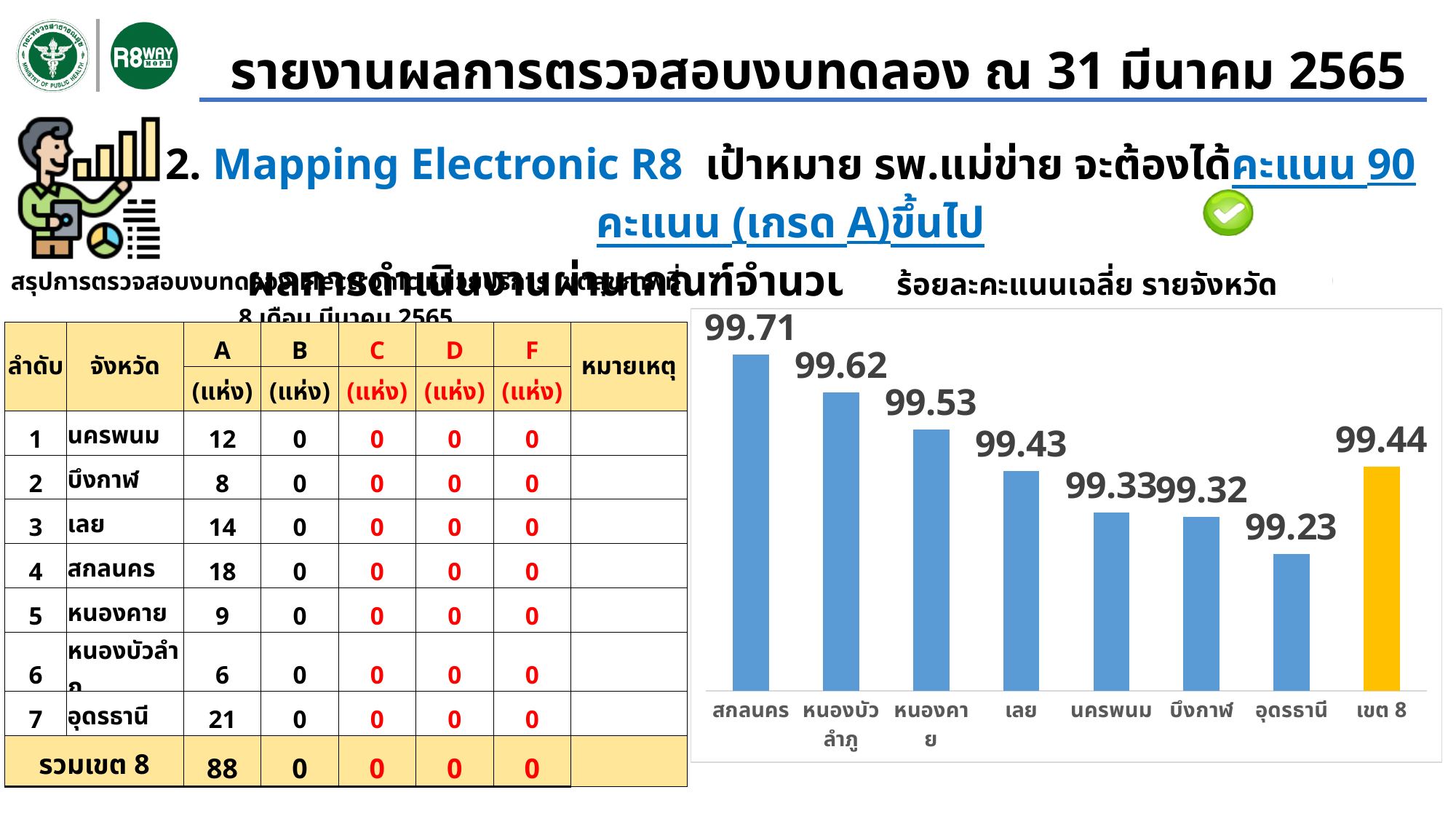
In the chart ร้อยละคะแนนเฉลี่ย รายจังหวัด, which bar is coloured differently (yellow) from the others? เขต 8 In the chart ร้อยละคะแนนเฉลี่ย รายจังหวัด, what is the difference between the values for สกลนคร and อุดรธานี? 0.48 In the chart ร้อยละคะแนนเฉลี่ย รายจังหวัด, what is the value for หนองบัวลำภู? 99.62 How many bars are plotted in the chart ร้อยละคะแนนเฉลี่ย รายจังหวัด? 8 In the chart ร้อยละคะแนนเฉลี่ย รายจังหวัด, which is larger, the value for เลย or the value for เขต 8? เขต 8 What type of chart is shown on the right side of the slide? bar chart In the chart ร้อยละคะแนนเฉลี่ย รายจังหวัด, what is the value for เขต 8? 99.44 In the chart ร้อยละคะแนนเฉลี่ย รายจังหวัด, which category has the lowest value? อุดรธานี In the chart ร้อยละคะแนนเฉลี่ย รายจังหวัด, what is the value for สกลนคร? 99.71 In the chart ร้อยละคะแนนเฉลี่ย รายจังหวัด, do the values of the province bars rise or fall from left to right (excluding เขต 8)? fall In the chart ร้อยละคะแนนเฉลี่ย รายจังหวัด, what is the value for อุดรธานี? 99.23 In the chart ร้อยละคะแนนเฉลี่ย รายจังหวัด, which category has the highest value? สกลนคร